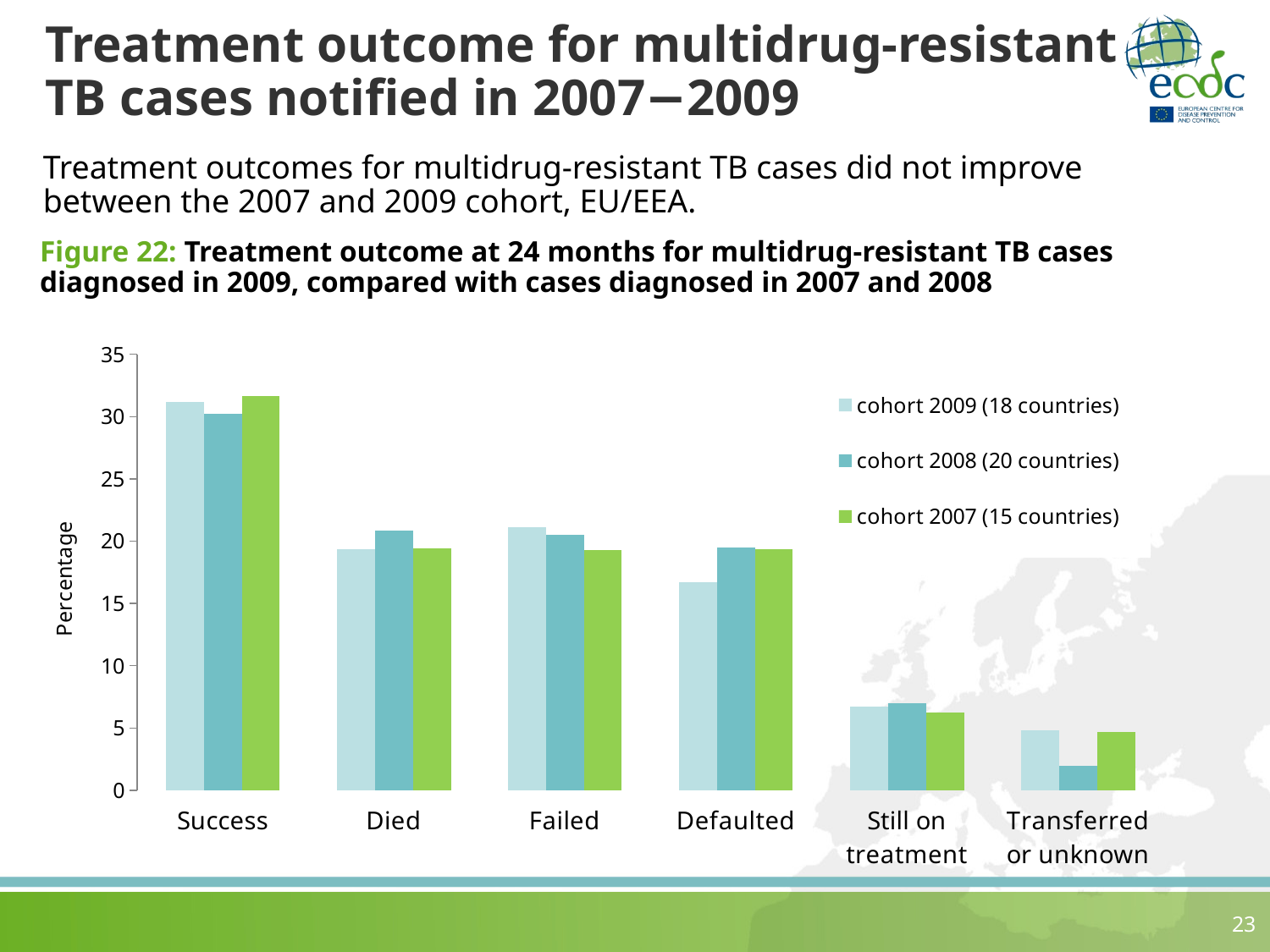
Is the value for Still on treatment in cohort 2007 greater or less than 10? less Which outcome category has the highest value for cohort 2009? Success How many series does the legend list? 3 What kind of chart is shown on the slide? bar chart Which outcome category has the lowest value for cohort 2008? Transferred or unknown Is the value for Success in cohort 2009 greater or less than 30? greater How many outcome categories are shown on the x axis? 6 For Defaulted, which is larger: cohort 2009 or cohort 2008? cohort 2008 What is the label on the y axis? Percentage Is the value for Defaulted in cohort 2009 greater or less than 20? less For Transferred or unknown, which is larger: cohort 2009 or cohort 2008? cohort 2009